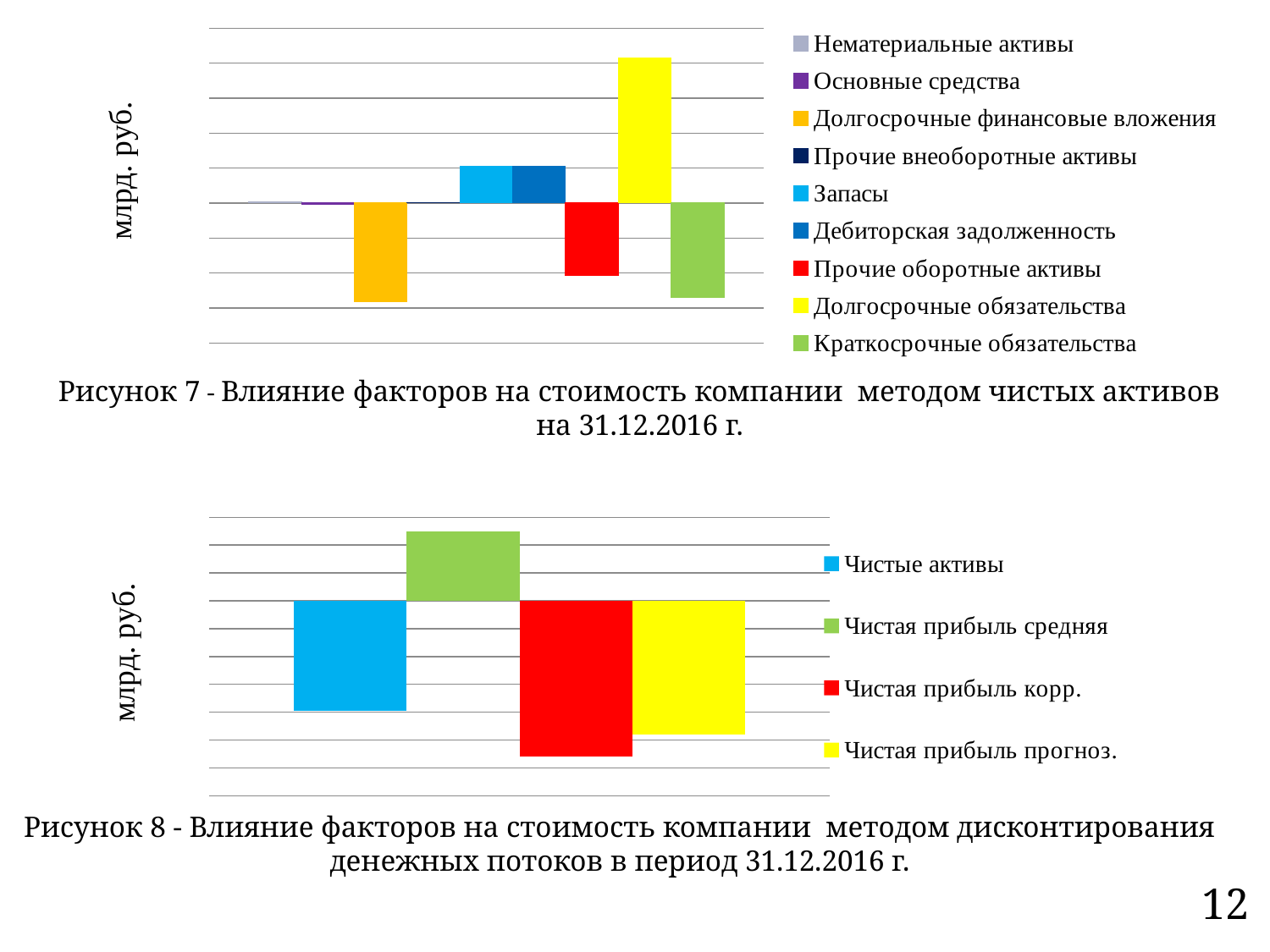
In the chart for Рисунок 7, is the value for Прочие оборотные активы greater or less than 0? less What kind of chart is shown in Рисунок 7? Bar chart In the chart for Рисунок 8, which series has the lowest value? Чистая прибыль корр. In the chart for Рисунок 7, what colour is the bar for Долгосрочные финансовые вложения? Orange In the chart for Рисунок 8, which series has the highest value? Чистая прибыль средняя In the chart for Рисунок 7, how many series does the legend list? 9 In the chart for Рисунок 7, which series has the highest value? Долгосрочные обязательства What unit is shown on the vertical axis of the chart for Рисунок 8? млрд. руб. In the chart for Рисунок 7, which is larger: the value for Долгосрочные обязательства or the value for Запасы? Долгосрочные обязательства What kind of chart is shown in Рисунок 8? Bar chart In the chart for Рисунок 8, how many series does the legend list? 4 In the chart for Рисунок 8, which is larger: the value for Чистая прибыль средняя or the value for Чистые активы? Чистая прибыль средняя